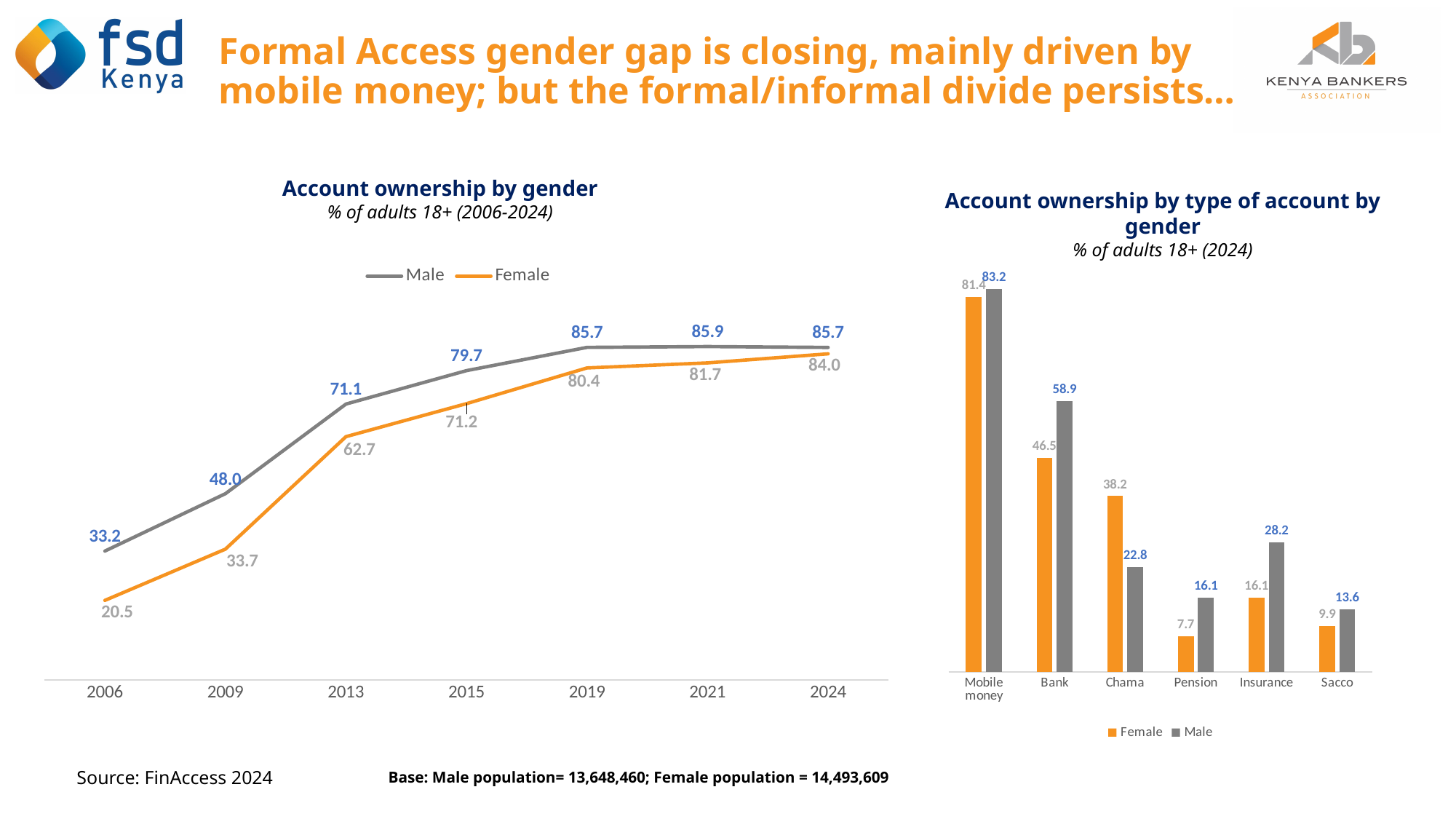
In the 'Account ownership by gender' chart, what is the Male value in 2006? 33.2 In the 'Account ownership by gender' chart, how many years are shown on the x axis? 7 What kind of chart is 'Account ownership by gender'? line chart In the 'Account ownership by gender' chart, does the Female line rise or fall from 2006 to 2024? rise In the 'Account ownership by type of account by gender' chart, which is larger for Chama: Female or Male? Female In the 'Account ownership by gender' chart, in which year is the Male value highest? 2021 In the 'Account ownership by gender' chart, what is the difference between the Male and Female values in 2024? 1.7 In the 'Account ownership by type of account by gender' chart, which account type has the lowest Female value? Pension How many series does the legend of the 'Account ownership by type of account by gender' chart list? 2 In the 'Account ownership by type of account by gender' chart, what is the difference between the Male and Female values for Insurance? 12.1 In the 'Account ownership by type of account by gender' chart, what is the Female value for Bank? 46.5 In the 'Account ownership by gender' chart, what is the Female value in 2013? 62.7